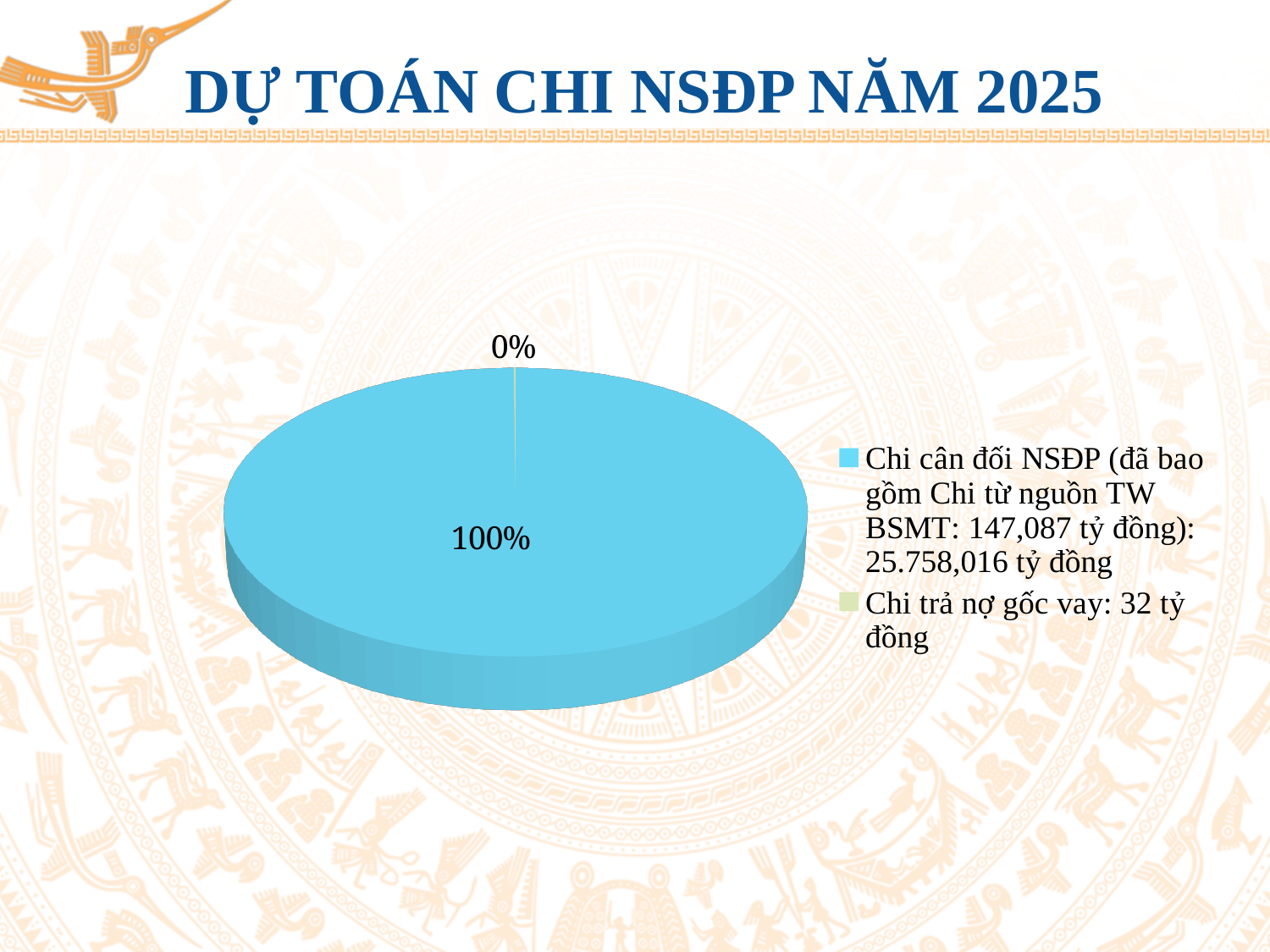
Which category has the smallest slice of the pie? Chi trả nợ gốc vay According to the legend, what is the value for Chi cân đối NSĐP? 25.758,016 tỷ đồng What colour is the slice for Chi cân đối NSĐP? light blue How many entries does the legend list? 2 What is the title of the chart on the slide? DỰ TOÁN CHI NSĐP NĂM 2025 How many slices does the pie chart have? 2 Which category has the largest slice of the pie? Chi cân đối NSĐP Which is larger, the slice for Chi cân đối NSĐP or the slice for Chi trả nợ gốc vay? Chi cân đối NSĐP According to the legend, what is the value for Chi trả nợ gốc vay? 32 tỷ đồng What kind of chart is shown on the slide? pie chart What share of the pie is labelled for Chi cân đối NSĐP? 100% What share of the pie is labelled for Chi trả nợ gốc vay? 0%